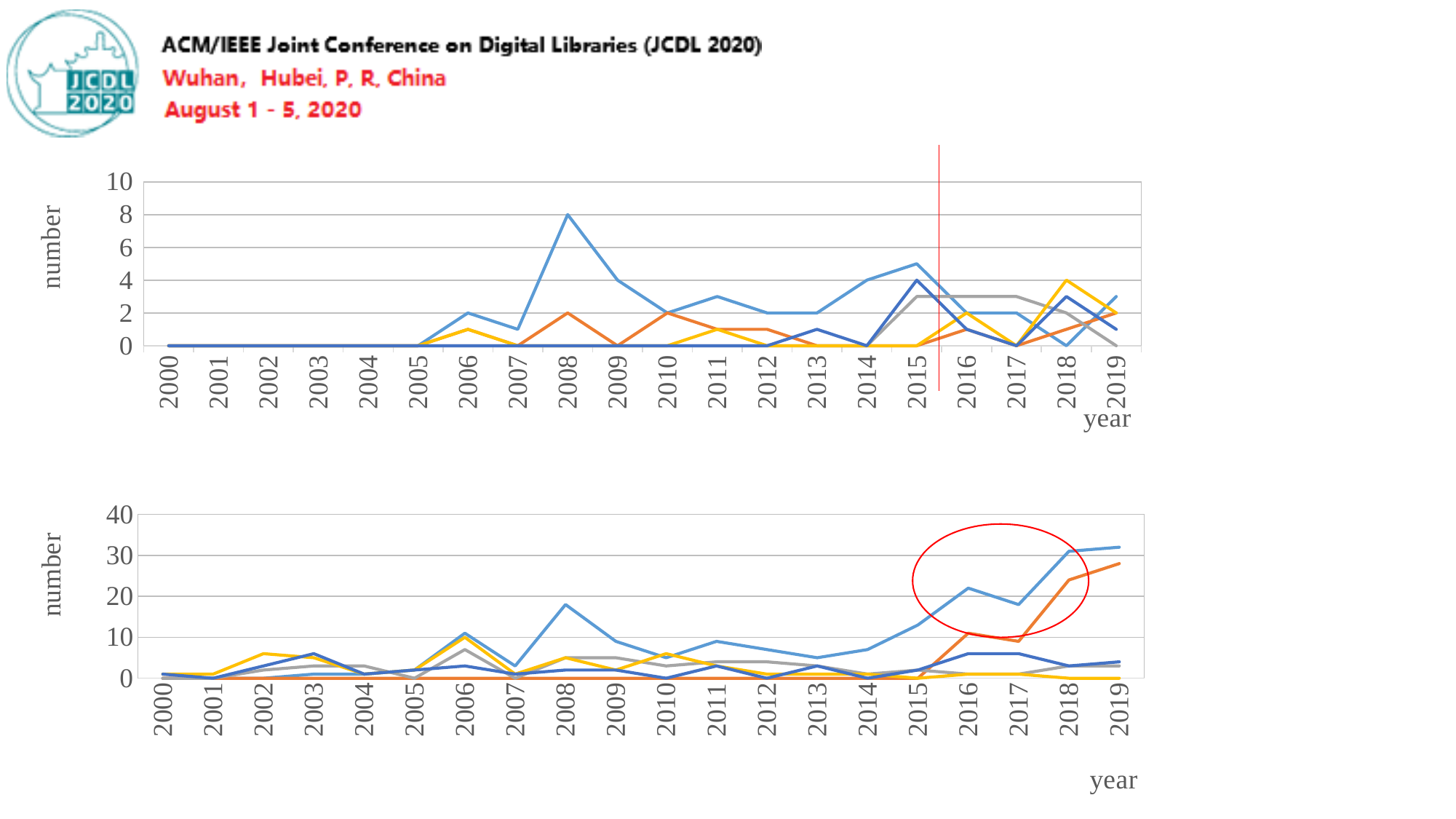
In the bottom chart, does the orange line rise or fall between 2015 and 2019? rise In the bottom chart, is the value of the light blue line in 2019 greater or less than 30? greater What is the highest tick value shown on the y axis of the bottom chart? 40 In the top chart, what is the value of the orange line in 2008? 2 How many years are shown along the x axis of the bottom chart? 20 What is the label on the y axis of the bottom chart? number In the top chart, what is the value of the light blue line in 2008? 8 In the bottom chart, is the value of the light blue line in 2008 greater or less than 10? greater In the top chart, which line has the larger value in 2008, the light blue line or the orange line? light blue line What kind of chart is the top chart on the slide? line chart In the top chart, in which year does the light blue line reach its highest value? 2008 In the bottom chart, is the value of the orange line in 2019 greater or less than 20? greater